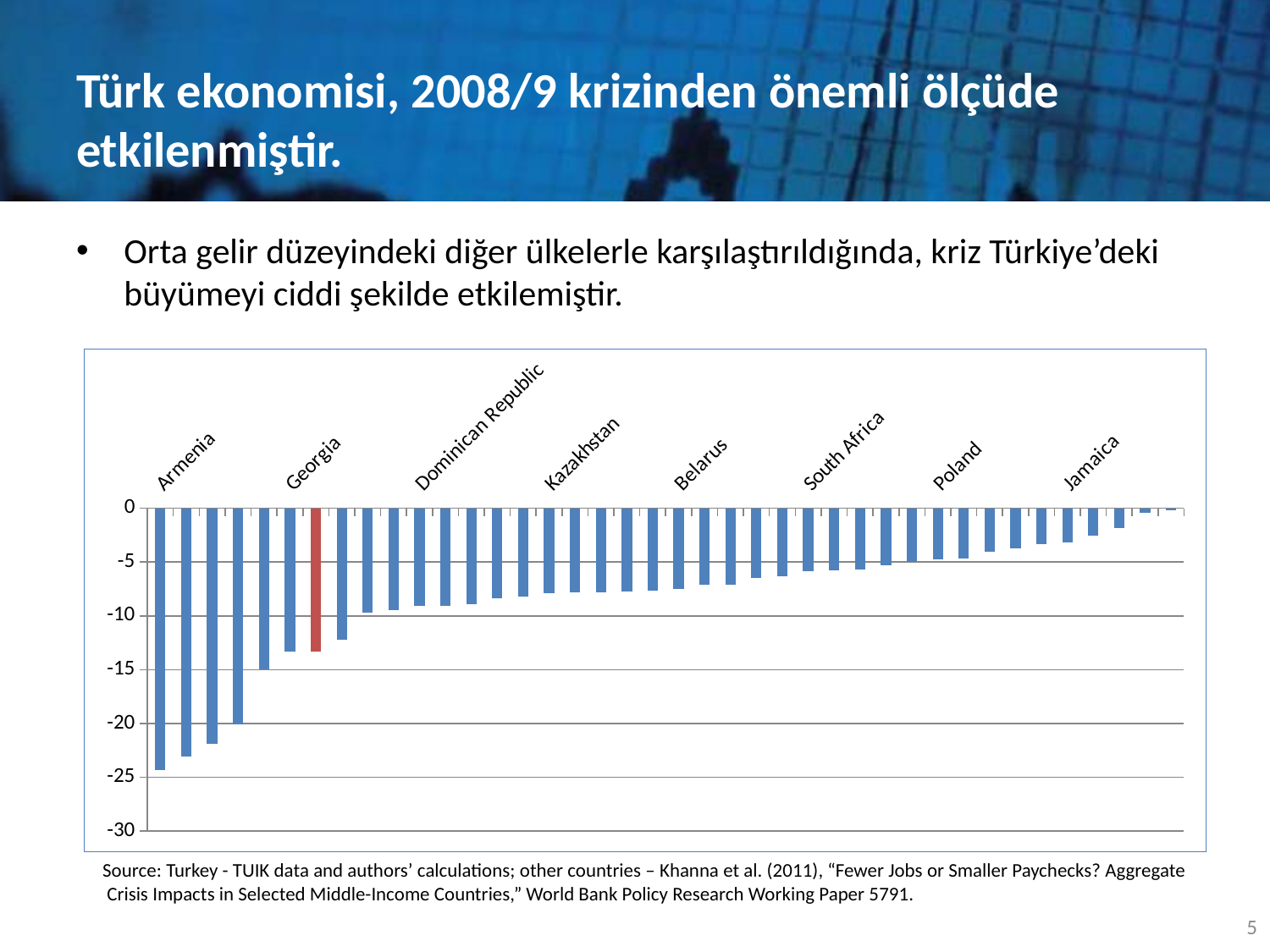
Do the bar values rise or fall moving from left to right along the x axis? rise Is the value for Armenia greater or less than -20? less Is the value for Georgia greater or less than -15? greater Which has the larger value, Kazakhstan or Jamaica? Jamaica Is the value for Belarus greater or less than -5? less Which has the larger value, Armenia or Georgia? Georgia Which labelled country has the lowest (most negative) value in the chart? Armenia What kind of chart is shown on the slide? bar chart What is the lowest value shown on the vertical axis? -30